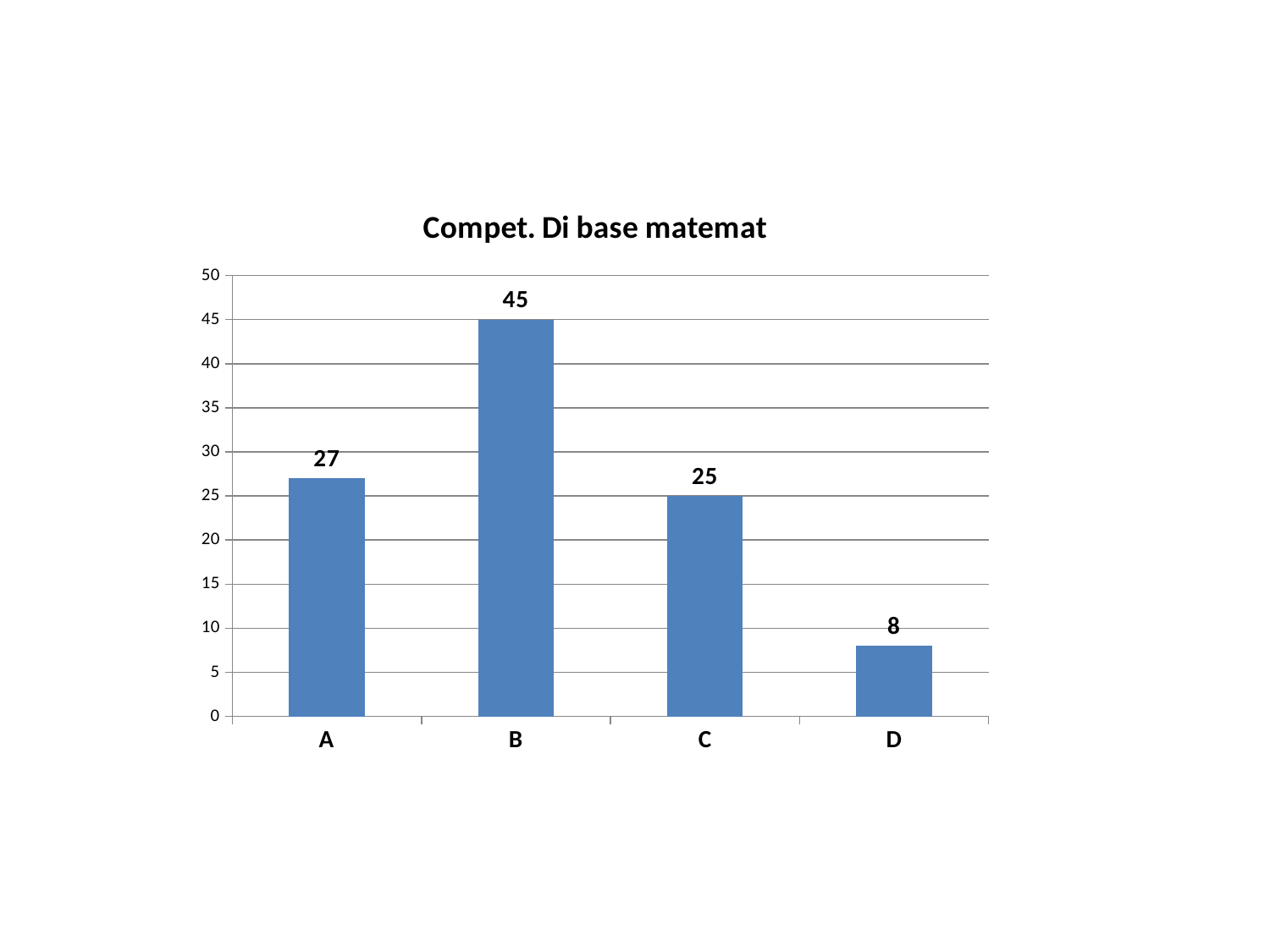
How many categories are shown on the x axis? 4 Which category has the lowest value? D What is the difference between the values for C and D? 17 What is the value for category C? 25 Which category has the highest value? B What is the value for category D? 8 What kind of chart is this? Bar chart What is the value for category B? 45 What is the difference between the values for B and A? 18 What is the value for category A? 27 Which is larger, the value for A or the value for C? A What is the title of the chart? Compet. Di base matemat